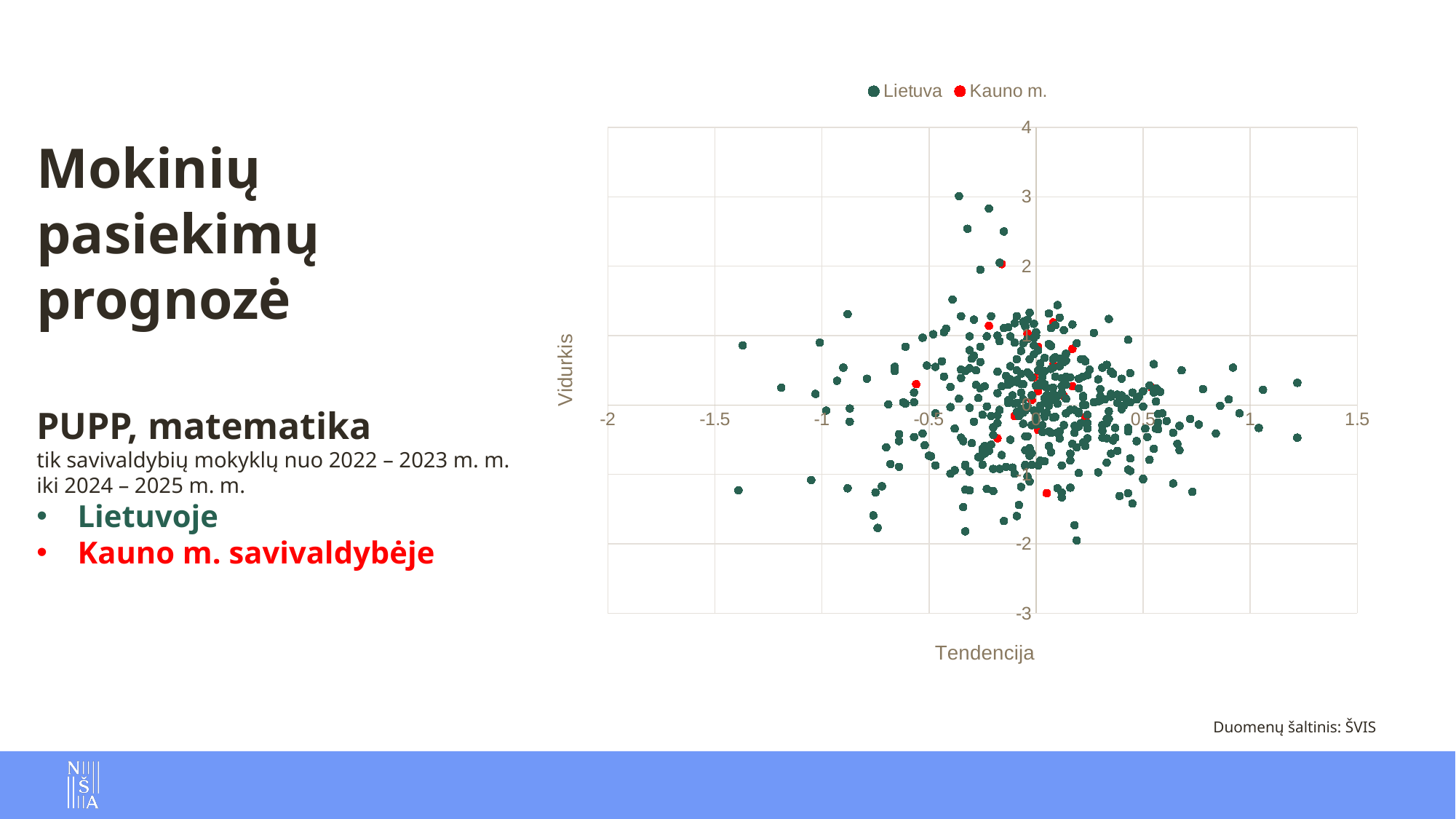
What is the leftmost tick value on the horizontal axis of the chart? -2 How many series does the chart legend list? 2 Is the Tendencija value of the rightmost Lietuva point greater or less than 1? greater What is the highest value shown on the vertical axis of the chart? 4 Is the Tendencija value of the leftmost Lietuva point greater or less than -1? less What kind of chart is shown on the slide? scatter plot What is the rightmost tick value on the horizontal axis of the chart? 1.5 What is the lowest value shown on the vertical axis of the chart? -3 What is the title of the horizontal axis of the chart? Tendencija Is the Vidurkis value of the lowest Kauno m. point greater or less than -1? less What are the two series named in the chart legend? Lietuva and Kauno m. What is the title of the vertical axis of the chart? Vidurkis